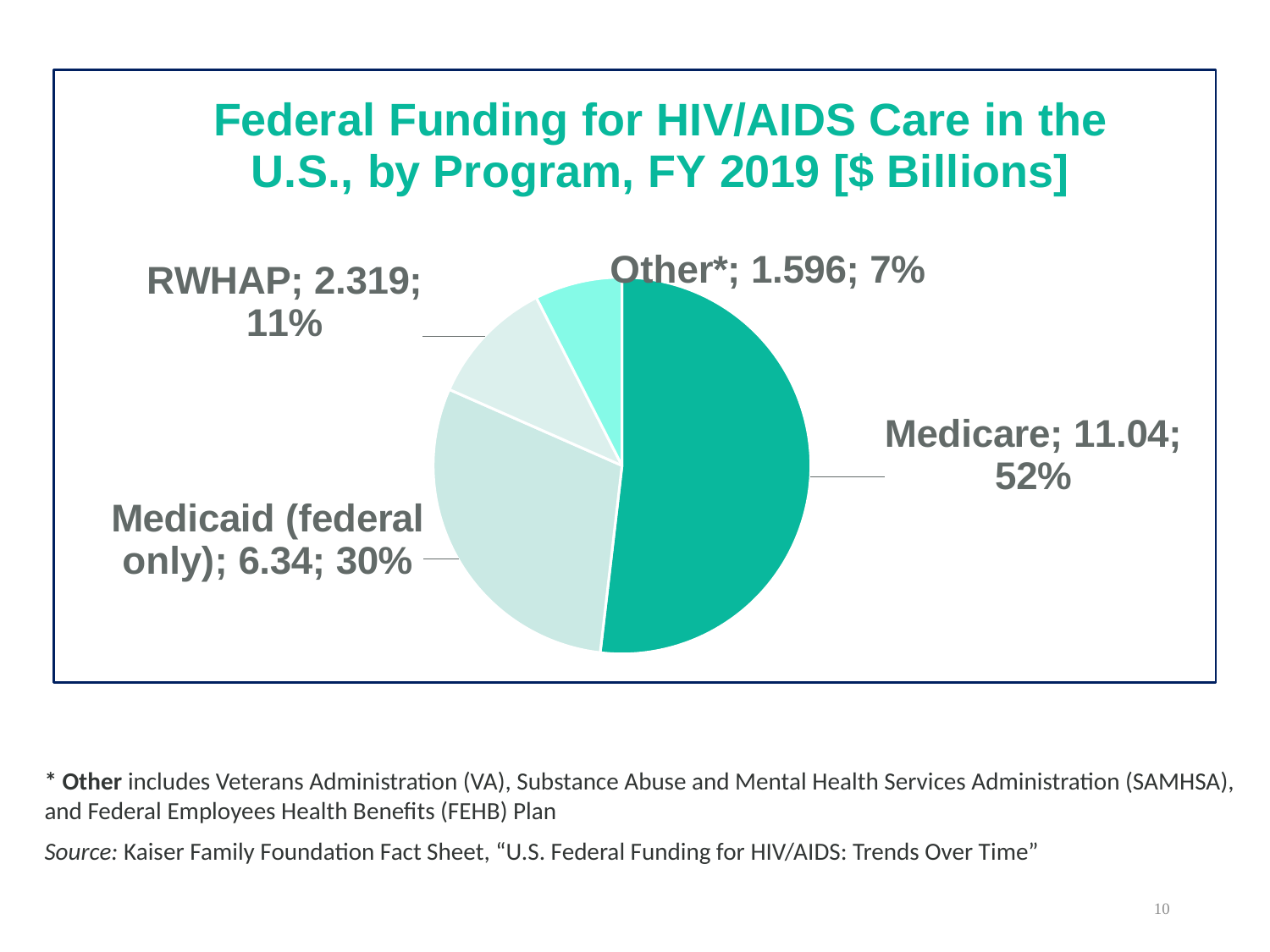
Which program has the largest share of federal funding? Medicare Which program has the smallest share of federal funding? Other* What is the difference between the Medicare and Medicaid (federal only) values? 4.7 What percentage share of the pie does Medicaid (federal only) represent? 30% What is the value for Medicaid (federal only)? 6.34 What is the value for Medicare? 11.04 What percentage share of the pie does RWHAP represent? 11% What is the value for RWHAP? 2.319 What is the value for Other*? 1.596 Which is larger, the value for RWHAP or the value for Other*? RWHAP What type of chart is shown on the slide? pie chart How many slices does the pie chart have? 4